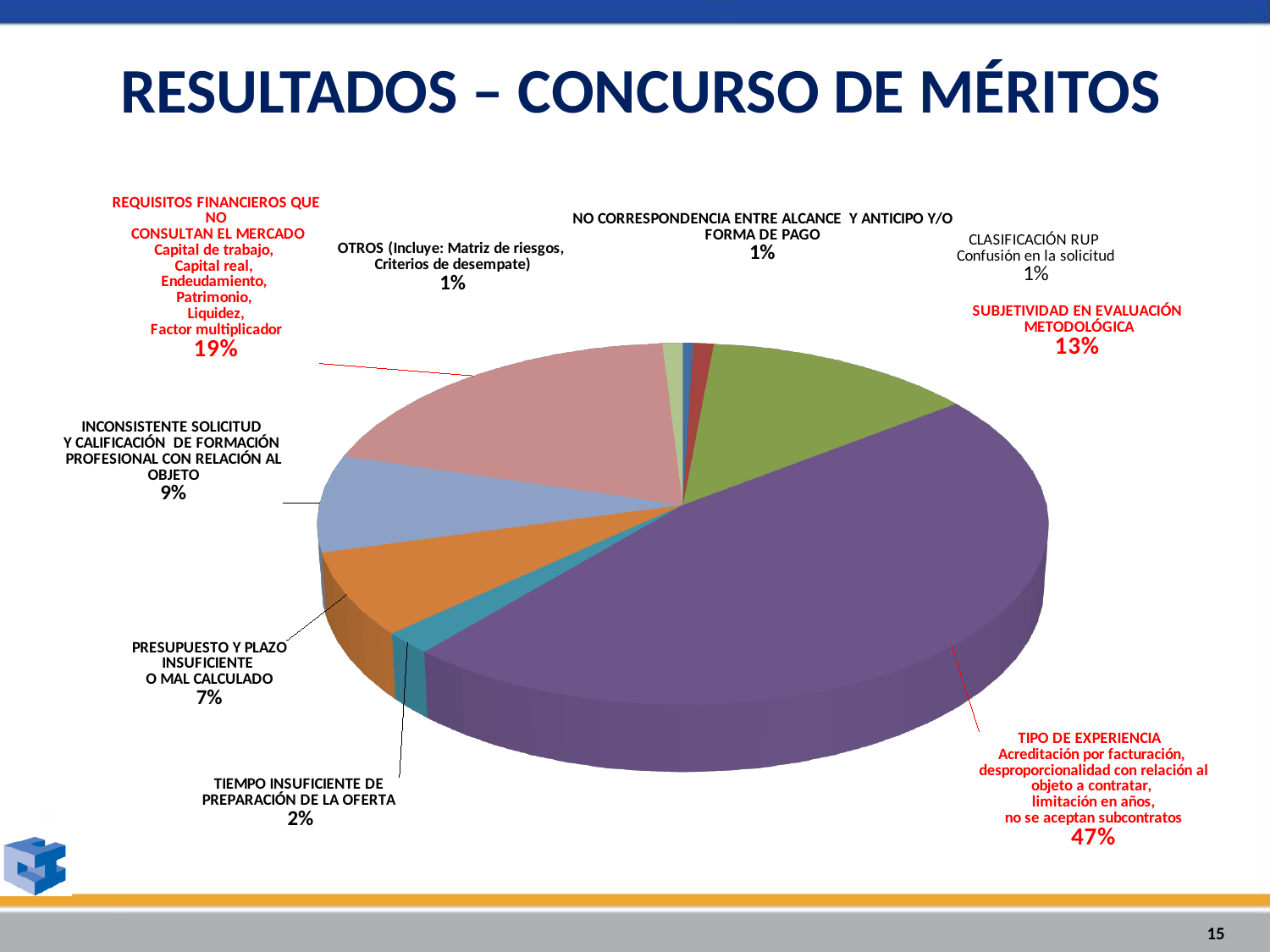
What is the value shown for CLASIFICACIÓN RUP? 1% What is the value shown for REQUISITOS FINANCIEROS QUE NO CONSULTAN EL MERCADO? 19% What is the value shown for PRESUPUESTO Y PLAZO INSUFICIENTE O MAL CALCULADO? 7% Which category has the largest slice of the pie? TIPO DE EXPERIENCIA What share of the pie does TIPO DE EXPERIENCIA represent? 47% What is the value shown for TIEMPO INSUFICIENTE DE PREPARACIÓN DE LA OFERTA? 2% How many slices does the pie chart have? 9 What is the title of the slide containing the pie chart? RESULTADOS – CONCURSO DE MÉRITOS Which is larger, the share for INCONSISTENTE SOLICITUD Y CALIFICACIÓN DE FORMACIÓN PROFESIONAL CON RELACIÓN AL OBJETO or the share for SUBJETIVIDAD EN EVALUACIÓN METODOLÓGICA? SUBJETIVIDAD EN EVALUACIÓN METODOLÓGICA What is the difference between the shares of TIPO DE EXPERIENCIA and REQUISITOS FINANCIEROS QUE NO CONSULTAN EL MERCADO? 28% What is the value shown for SUBJETIVIDAD EN EVALUACIÓN METODOLÓGICA? 13% What kind of chart is shown on the slide? Pie chart